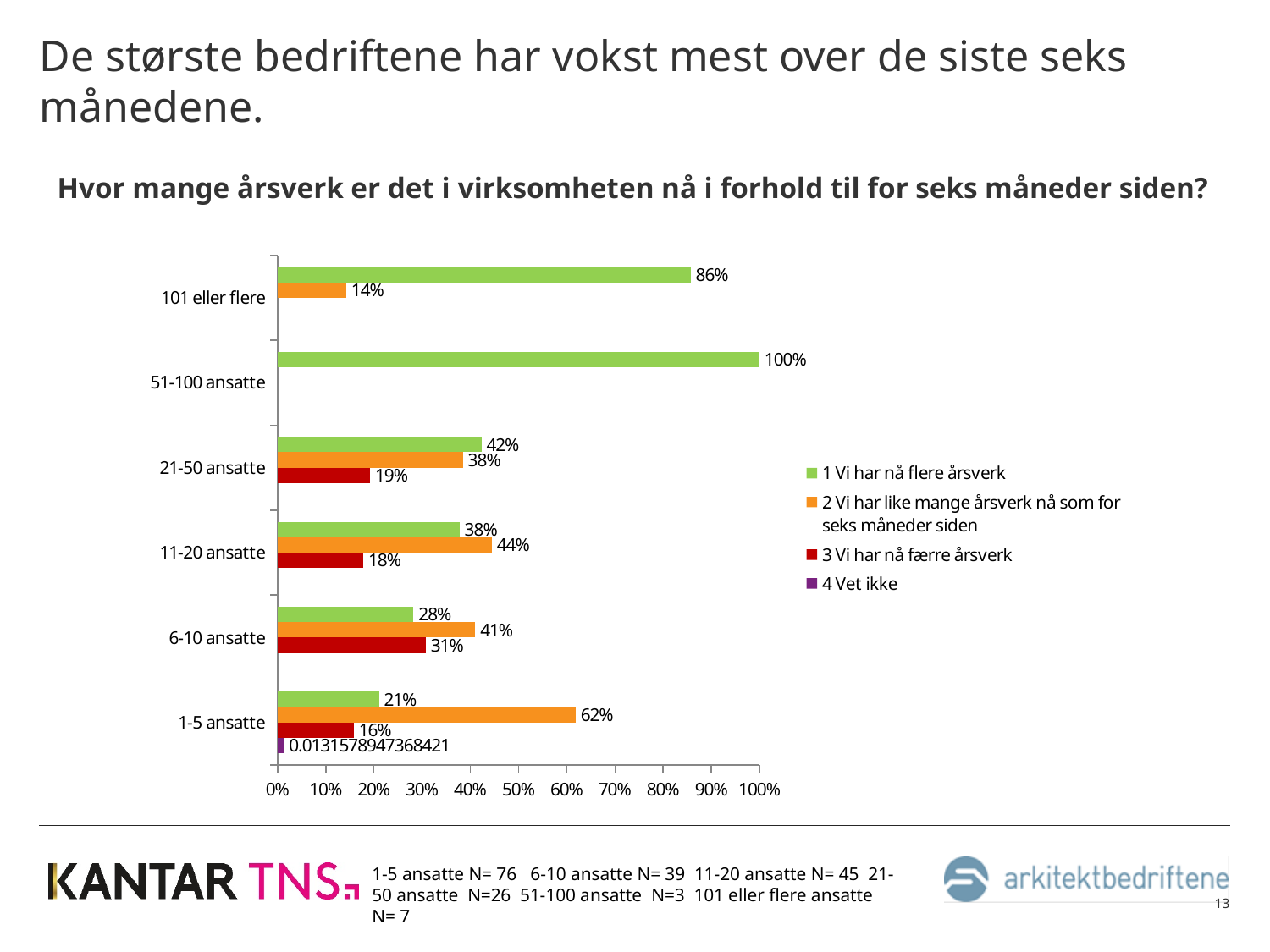
What is the value for '1 Vi har nå flere årsverk' in the '51-100 ansatte' category? 100% What is the value for '1 Vi har nå flere årsverk' in the '101 eller flere' category? 86% What is the value for '3 Vi har nå færre årsverk' in the '6-10 ansatte' category? 31% How many series does the legend list? 4 In the '11-20 ansatte' category, which is larger: '1 Vi har nå flere årsverk' or '2 Vi har like mange årsverk nå som for seks måneder siden'? 2 Vi har like mange årsverk nå som for seks måneder siden Which category has the highest value for '1 Vi har nå flere årsverk'? 51-100 ansatte Which category has the lowest value for '2 Vi har like mange årsverk nå som for seks måneder siden' among those with a labelled value? 101 eller flere Which category is the only one with a bar for '4 Vet ikke'? 1-5 ansatte What kind of chart is shown on the slide? bar chart What is the value for '2 Vi har like mange årsverk nå som for seks måneder siden' in the '1-5 ansatte' category? 62% How many company-size categories are shown on the y axis? 6 What is the difference between the '1 Vi har nå flere årsverk' values for '21-50 ansatte' and '1-5 ansatte'? 21%